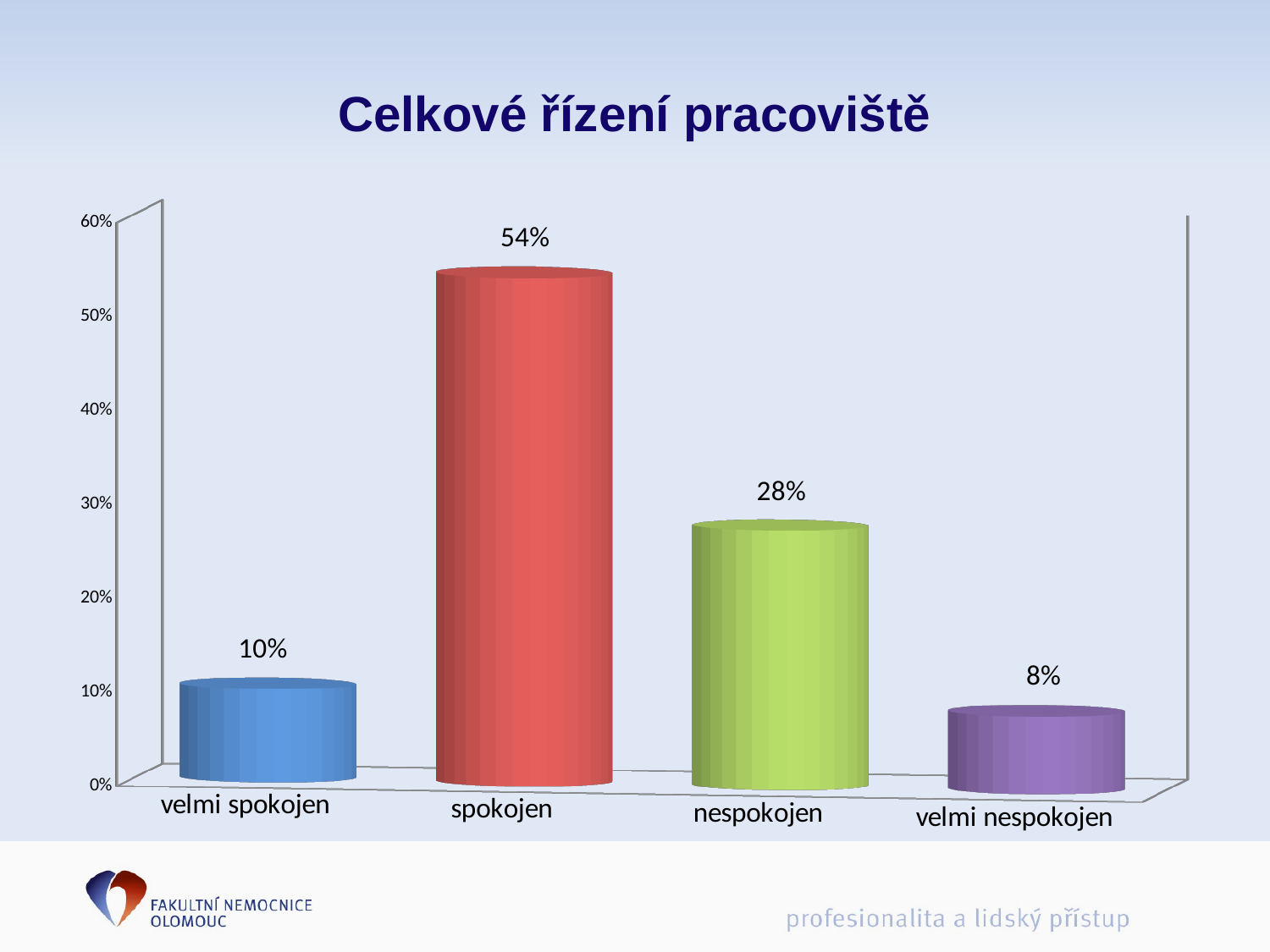
What is the value for "velmi nespokojen"? 8% What is the difference between the values for "spokojen" and "nespokojen"? 26% Which category has the highest value? spokojen What colour is the bar for "nespokojen"? green Is the value for "nespokojen" greater or less than 30%? less How many categories are shown on the x axis? 4 What is the value for "velmi spokojen"? 10% Which is larger, the value for "velmi spokojen" or the value for "velmi nespokojen"? velmi spokojen What is the title of the chart? Celkové řízení pracoviště What is the value for "spokojen"? 54% What kind of chart is shown on the slide? bar chart Which category has the lowest value? velmi nespokojen